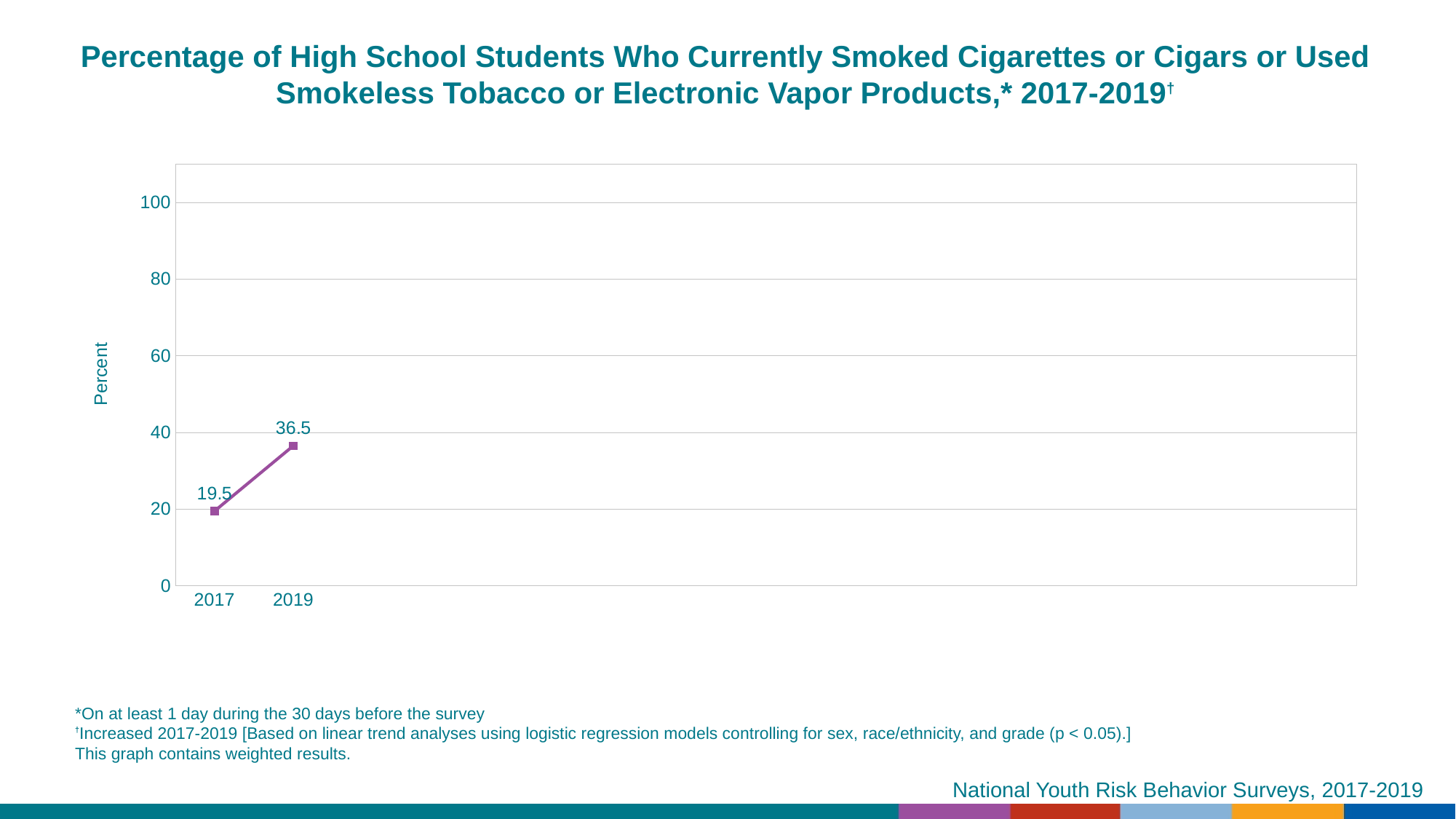
Which is larger, the value for 2017 or the value for 2019? 2019 What is the value for 2017? 19.5 Which year has the lowest value? 2017 Is the value for 2019 greater or less than 40? less How many data points are plotted on the chart? 2 Do the values rise or fall from 2017 to 2019? rise Is the value for 2017 greater or less than 20? less What is the label on the y axis? Percent Which year has the highest value? 2019 What is the difference between the 2019 and 2017 values? 17.0 What kind of chart is shown on the slide? line chart What is the value for 2019? 36.5